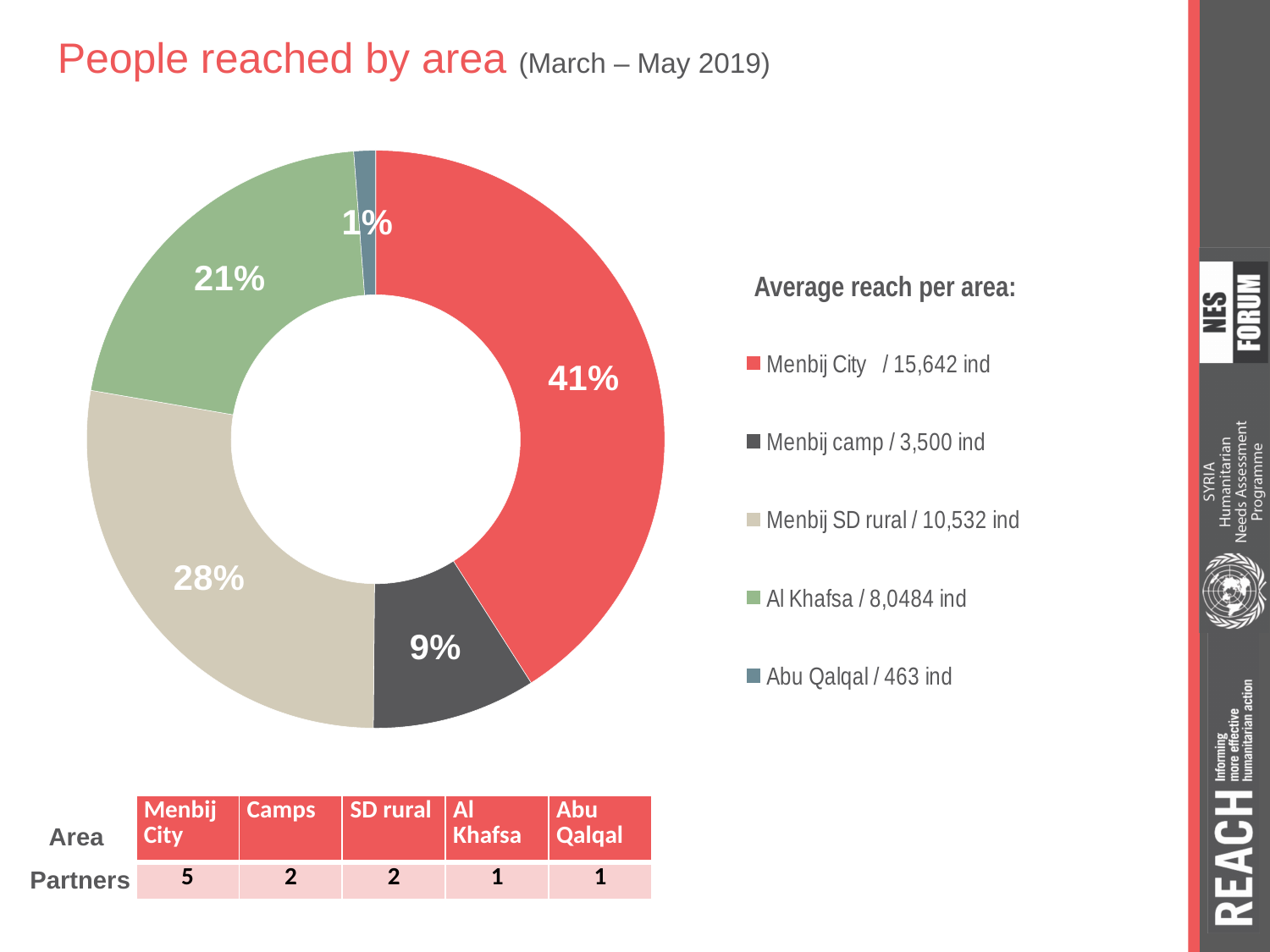
Which area has the smallest share of people reached? Abu Qalqal What share of people reached does Abu Qalqal account for? 1% Which has a larger share of people reached, Al Khafsa or Menbij camp? Al Khafsa What share of people reached does Menbij camp account for? 9% What share of people reached does Al Khafsa account for? 21% What type of chart is shown on the slide? Doughnut chart According to the legend, what is the average reach for Menbij camp? 3,500 ind How many areas are shown in the pie chart? 5 Which area has the largest share of people reached? Menbij City How many percentage points larger is the Menbij City share than the Menbij SD rural share? 13 percentage points